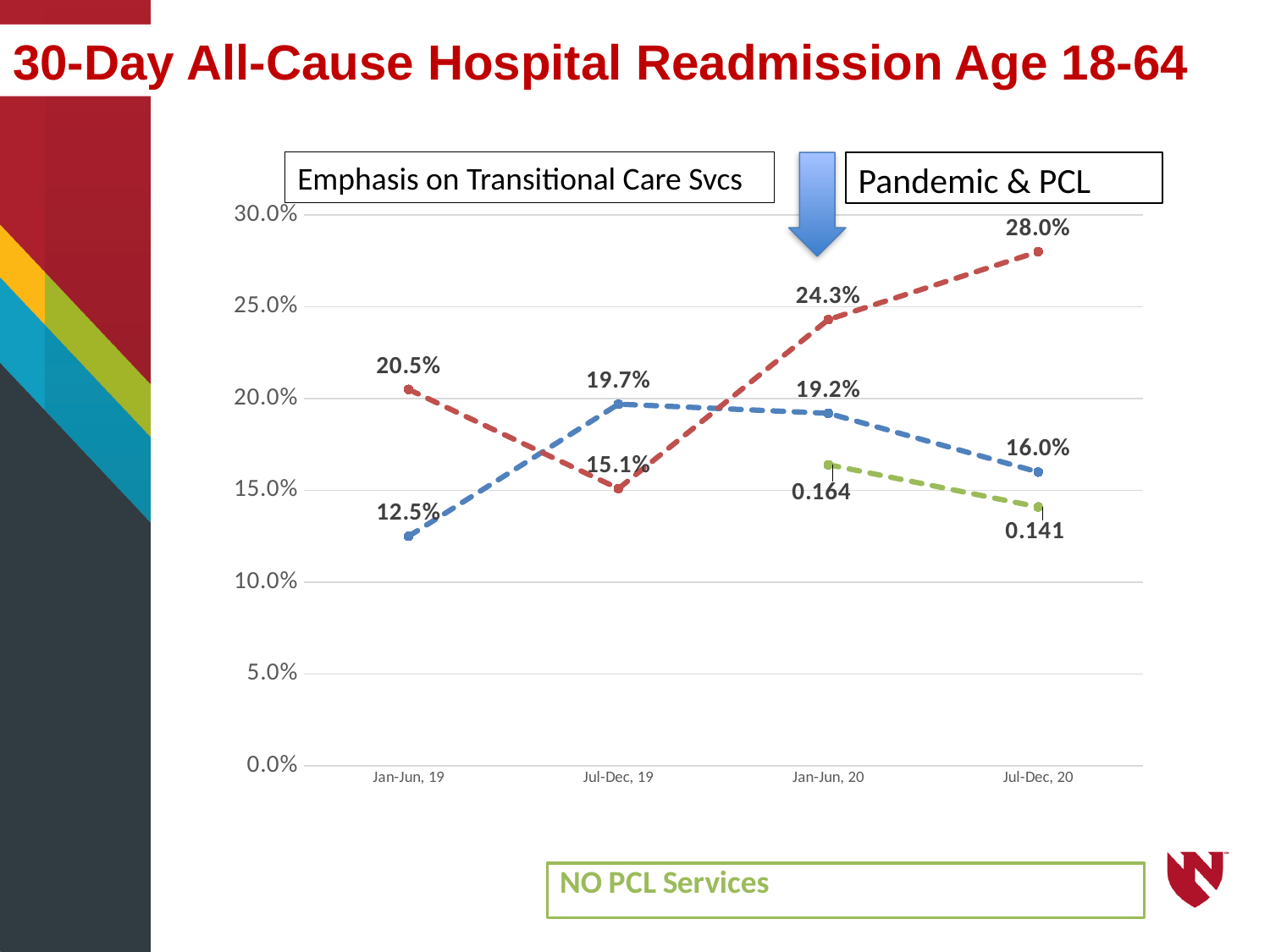
What is the title of the slide? 30-Day All-Cause Hospital Readmission Age 18-64 What is the value of the blue dashed line at Jan-Jun, 19? 12.5% What is the difference between the red dashed line's values at Jul-Dec, 20 and Jan-Jun, 20? 3.7% At Jan-Jun, 20, which line has the higher value, the red dashed line or the blue dashed line? red dashed line What is the value of the red dashed line at Jul-Dec, 19? 15.1% What is the value of the red dashed line at Jul-Dec, 20? 28.0% Does the red dashed line rise or fall from Jul-Dec, 19 to Jul-Dec, 20? rise What kind of chart is shown on the slide? line chart How many time periods are shown on the x axis? 4 What is the value of the green dashed line at Jan-Jun, 20? 0.164 In which period does the red dashed line reach its highest value? Jul-Dec, 20 In which period does the blue dashed line have its lowest value? Jan-Jun, 19